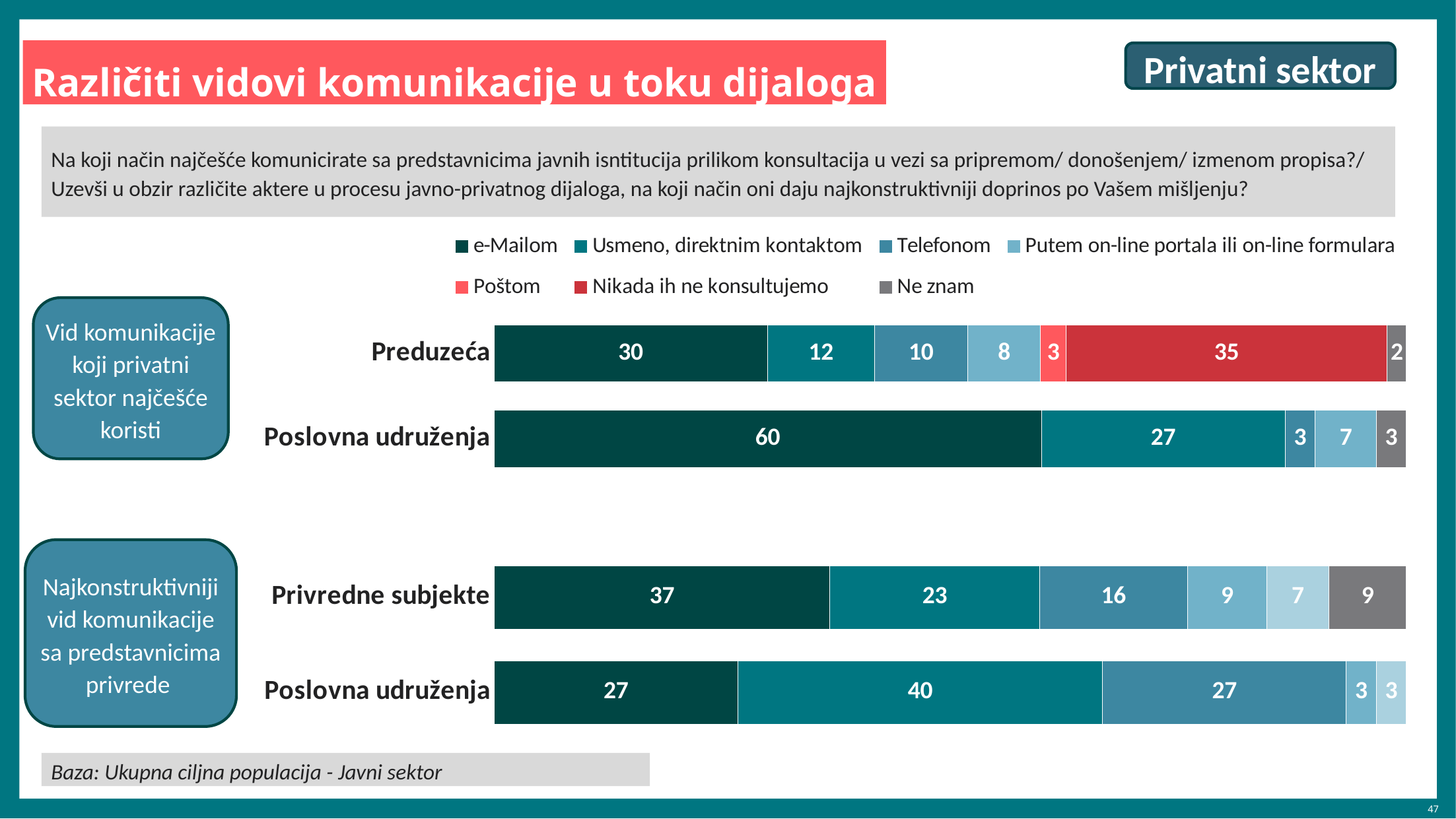
In the upper chart (Vid komunikacije koji privatni sektor najčešće koristi), what is the value for e-Mailom for Preduzeća? 30 In the upper chart (Vid komunikacije koji privatni sektor najčešće koristi), what is the difference between the e-Mailom values for Poslovna udruženja and Preduzeća? 30 In the upper chart (Vid komunikacije koji privatni sektor najčešće koristi), what is the value for e-Mailom for Poslovna udruženja? 60 What kind of chart is used on this slide? Stacked bar chart In the lower chart (Najkonstruktivniji vid komunikacije sa predstavnicima privrede), what is the value for Usmeno, direktnim kontaktom for Poslovna udruženja? 40 In the upper chart (Vid komunikacije koji privatni sektor najčešće koristi), which series has the largest segment for Preduzeća? Nikada ih ne konsultujemo How many series does the legend list? 7 In the upper chart (Vid komunikacije koji privatni sektor najčešće koristi), what is the value for Nikada ih ne konsultujemo for Preduzeća? 35 In the lower chart (Najkonstruktivniji vid komunikacije sa predstavnicima privrede), which is larger: e-Mailom for Privredne subjekte or e-Mailom for Poslovna udruženja? Privredne subjekte In the lower chart (Najkonstruktivniji vid komunikacije sa predstavnicima privrede), which series has the largest segment for Privredne subjekte? e-Mailom In the lower chart (Najkonstruktivniji vid komunikacije sa predstavnicima privrede), what is the total of the stacked bar for Poslovna udruženja? 100